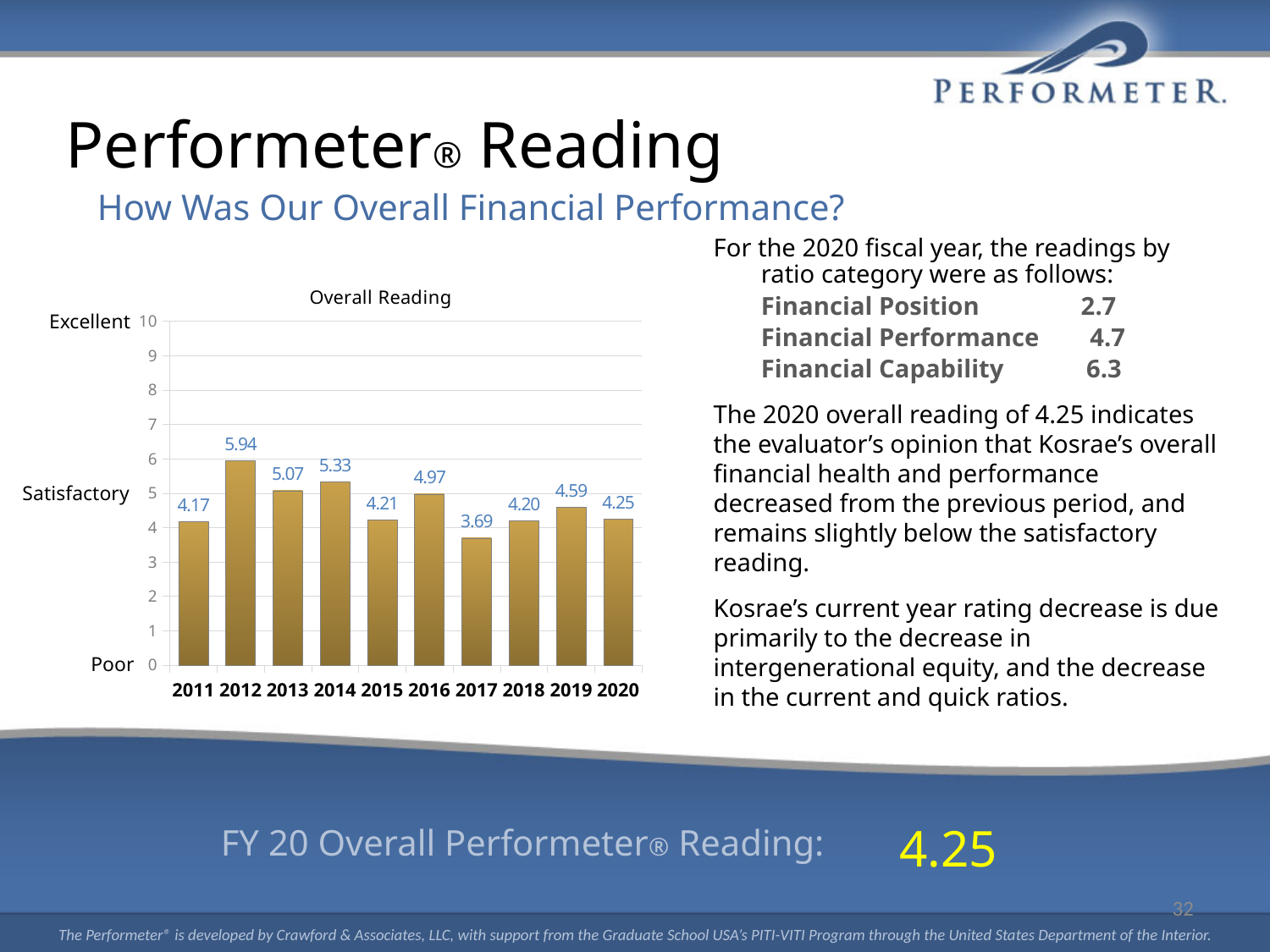
What kind of chart is the Overall Reading chart? bar chart How many years are shown on the Overall Reading chart? 10 Which year has a higher Overall Reading, 2014 or 2016? 2014 What is the difference between the Overall Reading for 2019 and 2020? 0.34 Did the Overall Reading rise or fall from 2019 to 2020? fall What label on the y axis corresponds to a reading of 5? Satisfactory Is the Overall Reading for 2018 greater or less than 5? less What is the Overall Reading value for 2012? 5.94 What is the Overall Reading value for 2020? 4.25 Which year has the lowest Overall Reading? 2017 What is the Overall Reading value for 2017? 3.69 Which year has the highest Overall Reading? 2012